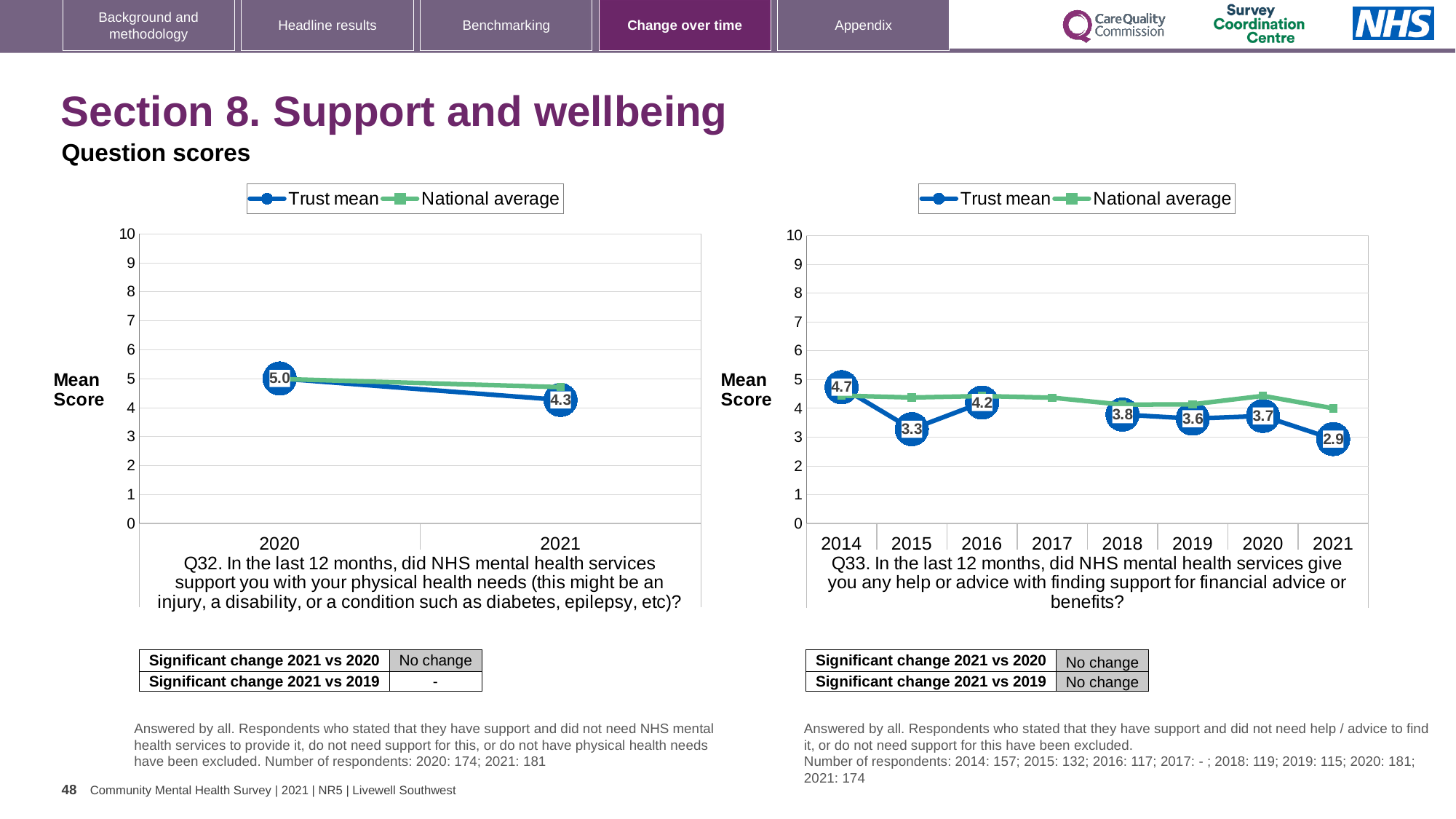
In the right chart (Q33), what is the Trust mean for 2014? 4.7 In the right chart (Q33), is the Trust mean for 2019 higher or lower than the Trust mean for 2020? lower How many series does the legend of the left chart list? 2 In the left chart (Q32), what is the Trust mean for 2021? 4.3 In the right chart (Q33), which year has the lowest Trust mean? 2021 In the right chart (Q33), which year has the highest Trust mean? 2014 In the right chart (Q33), what is the difference between the Trust mean in 2015 and in 2016? 0.9 In the left chart (Q32), what is the Trust mean for 2020? 5.0 In the right chart (Q33), what is the Trust mean for 2021? 2.9 What type of chart is used on the right side of the slide? Line chart In the left chart (Q32), by how much did the Trust mean fall from 2020 to 2021? 0.7 In the right chart (Q33), is the National average for 2021 greater or less than 3? greater